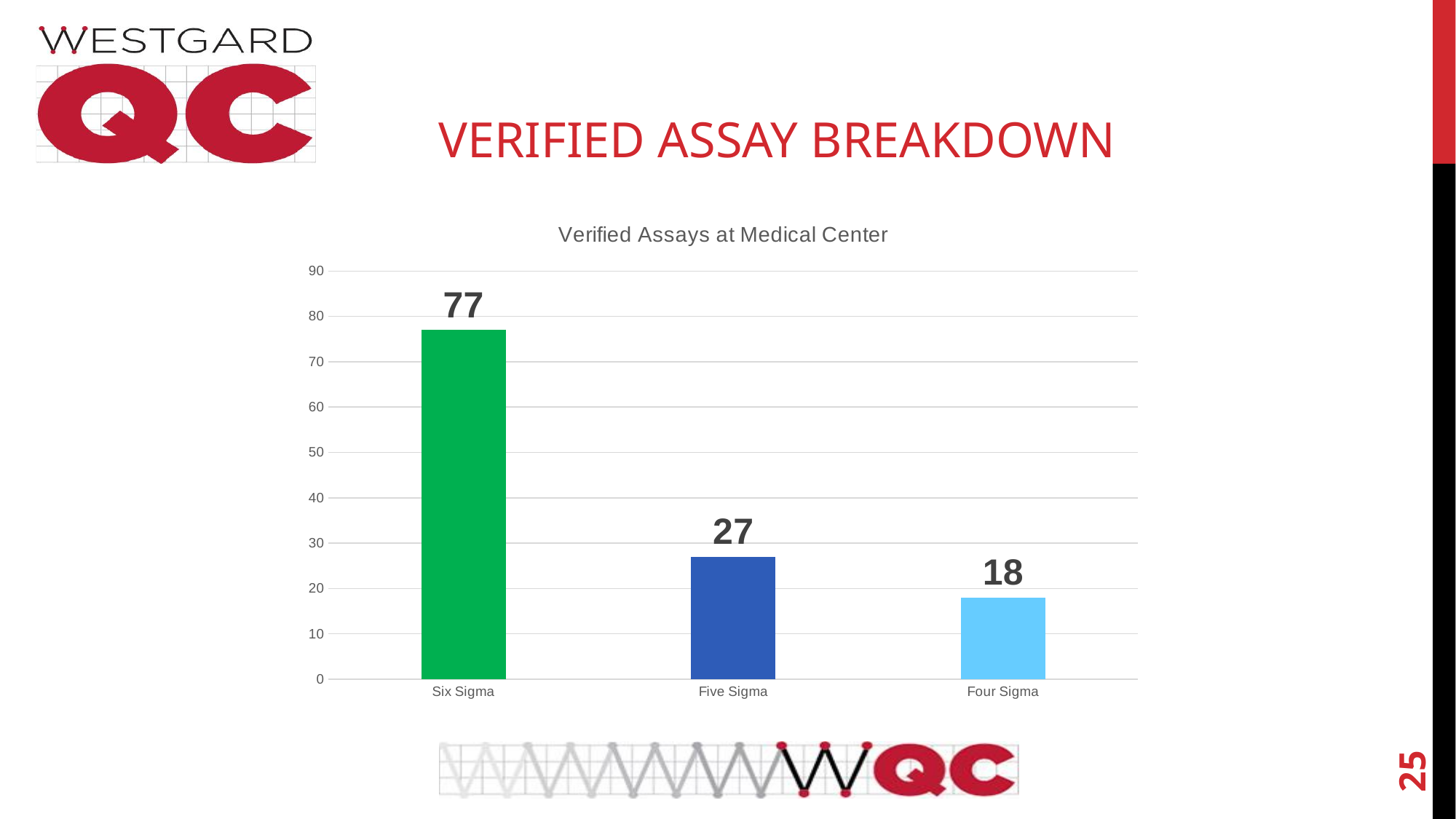
What is the difference between the values for Six Sigma and Five Sigma? 50 What is the value for Four Sigma? 18 What kind of chart is shown on the slide? bar chart How many categories are shown on the x axis? 3 Which category has the lowest value? Four Sigma What is the value for Six Sigma? 77 Which is larger, the value for Five Sigma or the value for Four Sigma? Five Sigma Is the value for Six Sigma greater or less than 70? greater What is the title of the chart? Verified Assays at Medical Center What is the difference between the values for Five Sigma and Four Sigma? 9 Which category has the highest value? Six Sigma What is the value for Five Sigma? 27